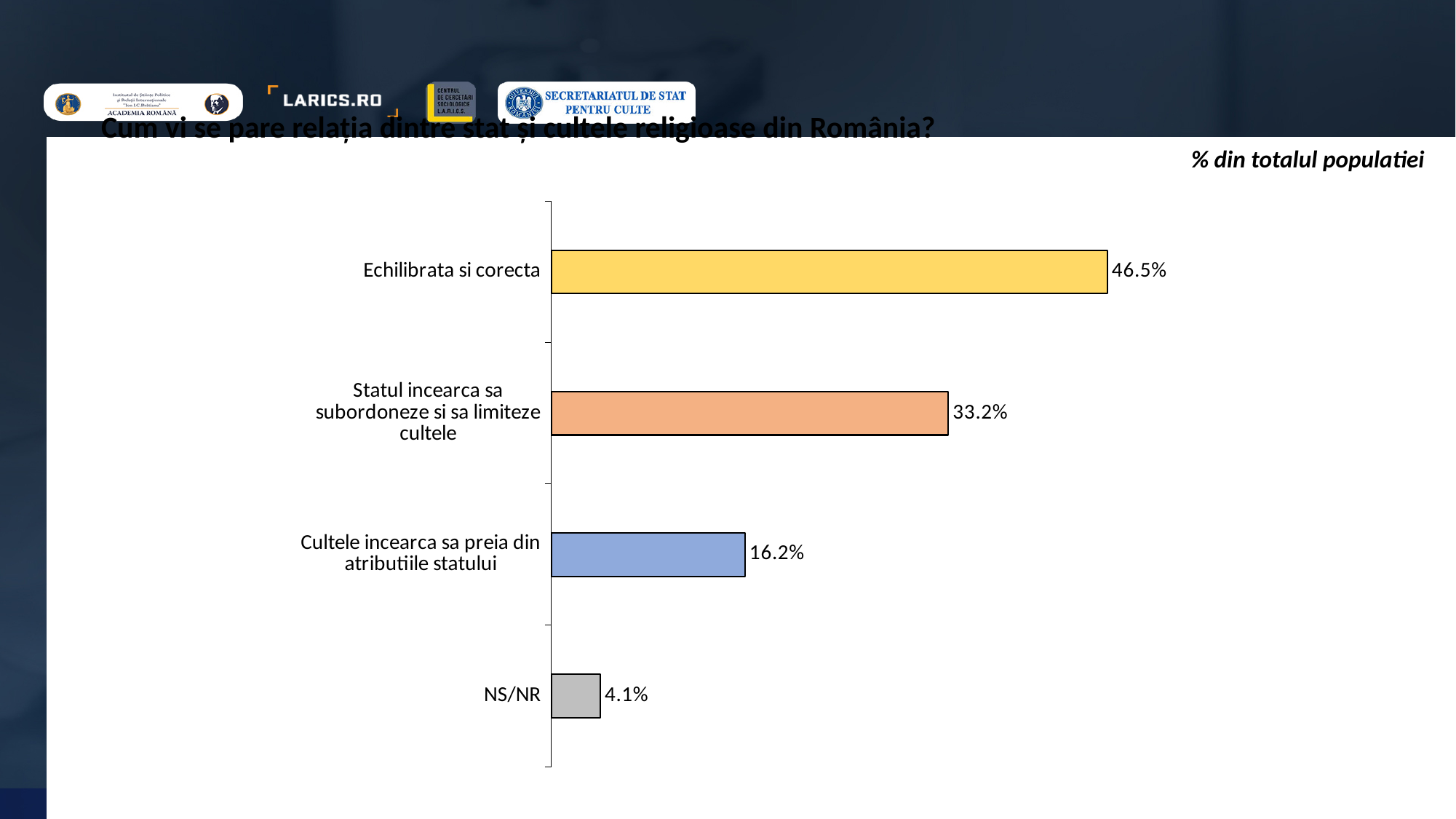
Which category has the lowest value? NS/NR What is the value for "Cultele incearca sa preia din atributiile statului"? 16.2% Which is larger: "Statul incearca sa subordoneze si sa limiteze cultele" or "Cultele incearca sa preia din atributiile statului"? Statul incearca sa subordoneze si sa limiteze cultele What unit note is shown at the top right of the chart? % din totalul populatiei What is the value for "Statul incearca sa subordoneze si sa limiteze cultele"? 33.2% What is the difference between "Echilibrata si corecta" and "Statul incearca sa subordoneze si sa limiteze cultele"? 13.3% What percentage of respondents answered "Echilibrata si corecta"? 46.5% Which category has the highest value? Echilibrata si corecta How many categories are shown in the chart? 4 What kind of chart is shown on the slide? Bar chart What is the value for NS/NR? 4.1% What is the difference between "Cultele incearca sa preia din atributiile statului" and NS/NR? 12.1%